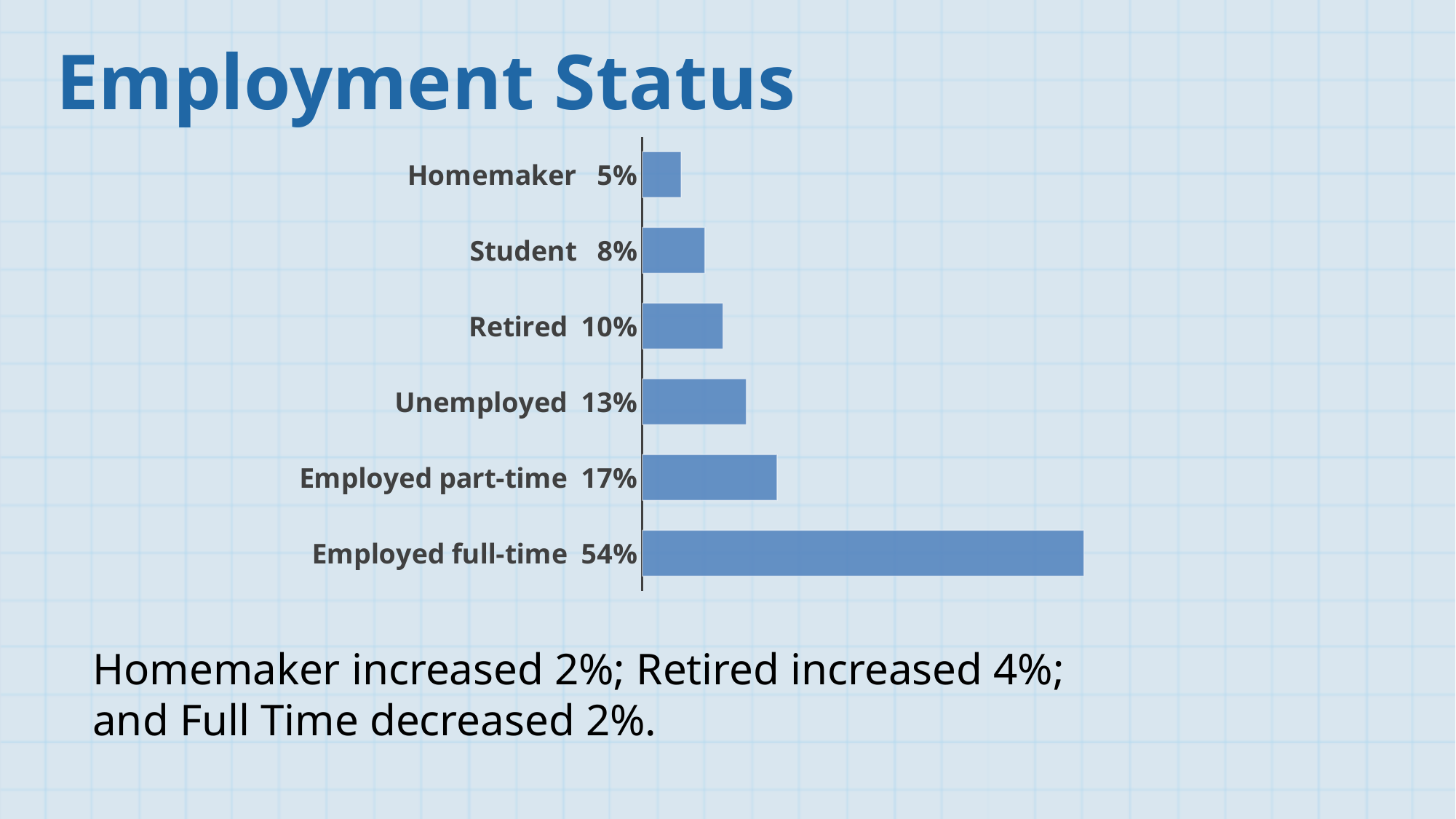
What is the value for Unemployed? 13% Which category has the highest value? Employed full-time What is the difference between Retired and Homemaker? 5% Which category has the lowest value? Homemaker According to the note below the chart, by how much did Retired increase? 4% What is the difference between Employed full-time and Employed part-time? 37% How many categories are shown in the chart? 6 What is the value for Employed full-time? 54% What is the title of the slide? Employment Status What kind of chart is shown on the slide? Bar chart Which is larger, Unemployed or Retired? Unemployed What is the value for Student? 8%